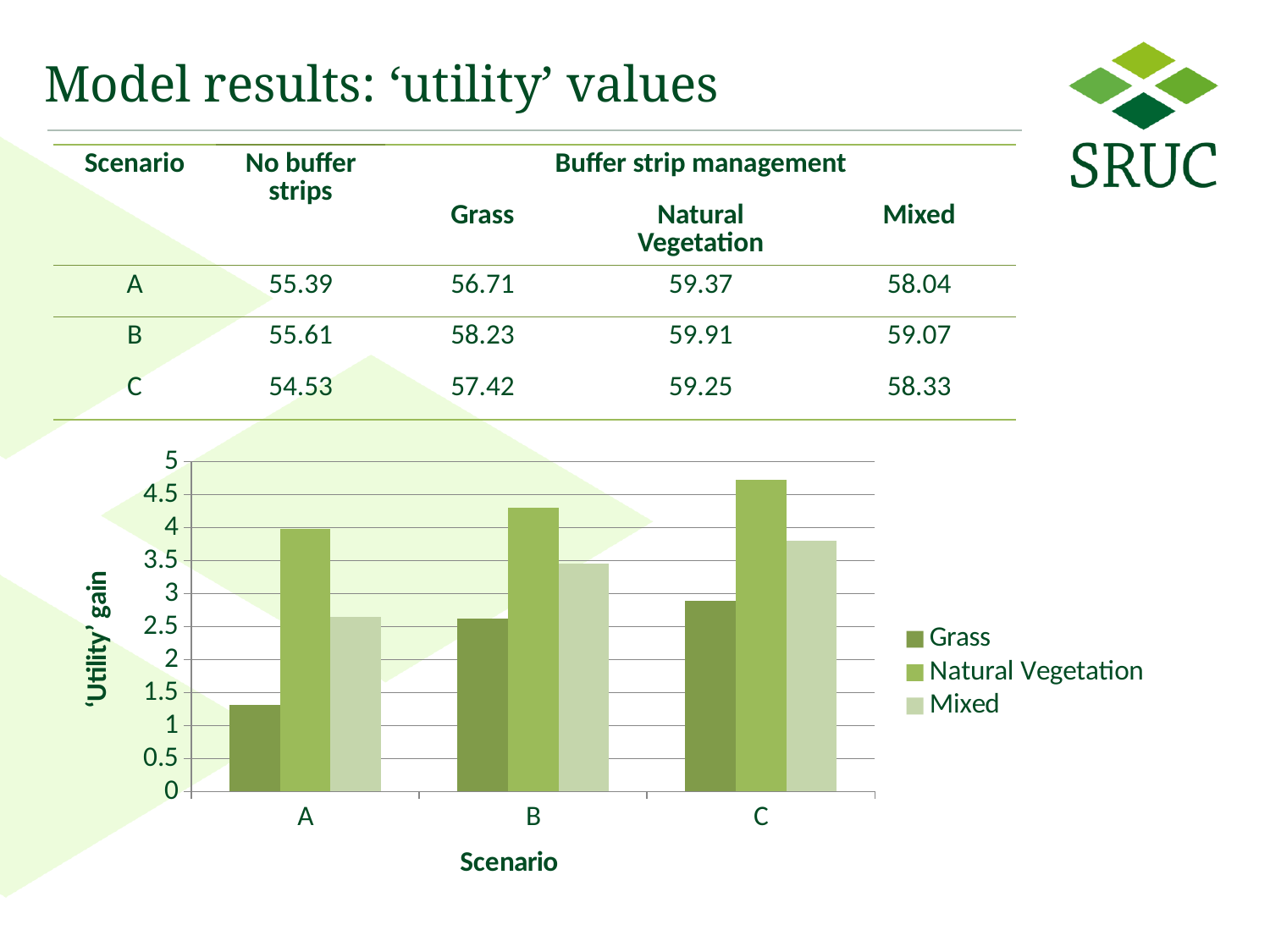
Do the Grass bars rise or fall from scenario A to scenario C? rise What is the title of the chart's vertical axis? 'Utility' gain Which scenario has the highest Natural Vegetation bar? C How many series does the chart legend list? 3 Is the Natural Vegetation value for scenario C greater or less than 4.5? greater Which scenario has the lowest Grass bar? A Is the Mixed value for scenario B greater or less than 3? greater What kind of chart is shown on the slide? bar chart In scenario B, which is larger: the Grass bar or the Mixed bar? Mixed Is the Grass value for scenario A greater or less than 1.5? less Which series has the tallest bar in every scenario? Natural Vegetation How many scenarios are plotted along the x axis of the chart? 3